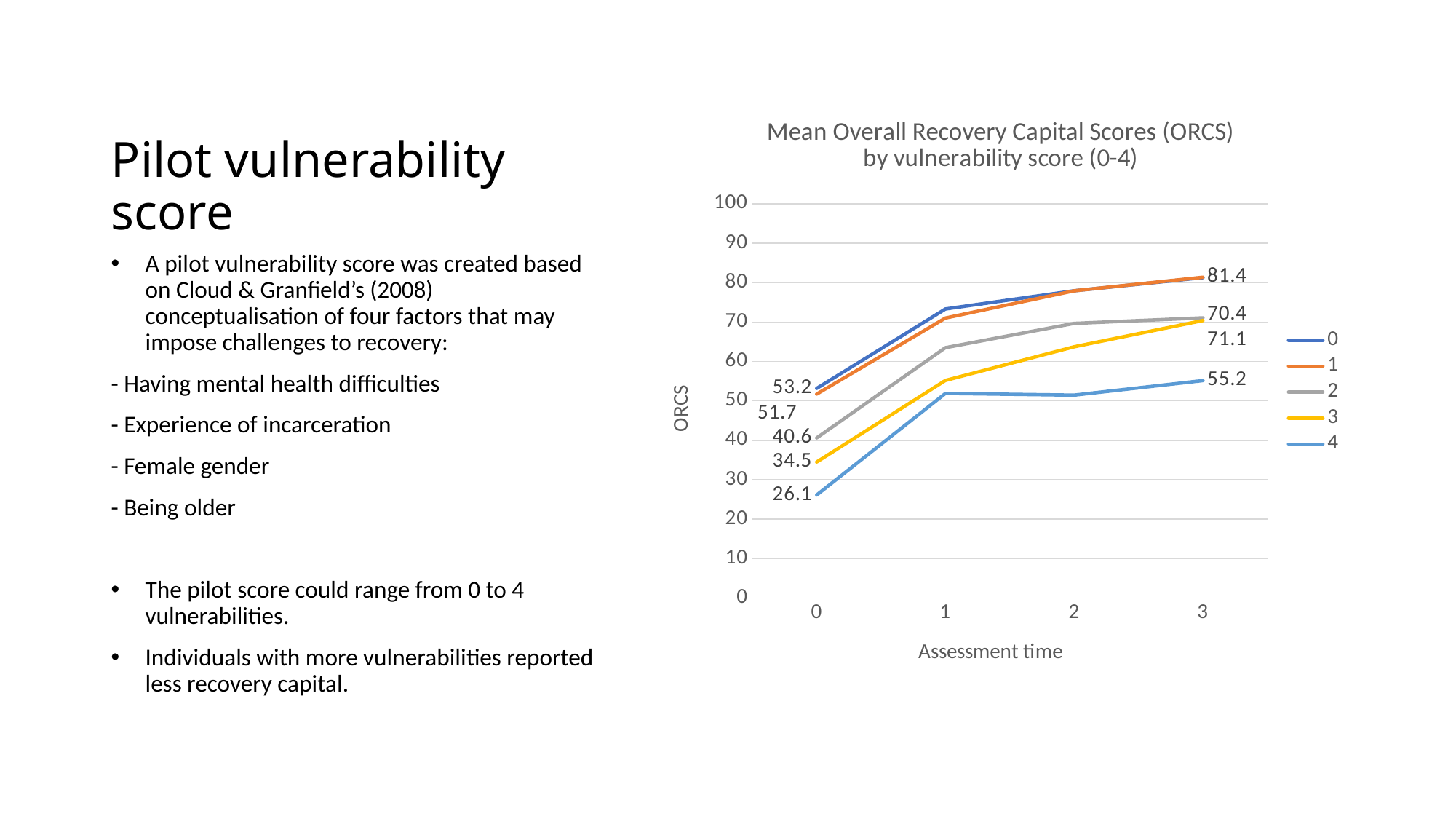
How many series does the legend list? 5 How many assessment time points are shown on the x axis? 4 What is the ORCS value for vulnerability score 0 at assessment time 0? 53.2 What kind of chart is shown on the slide? line chart By how much does the ORCS value for vulnerability score 4 increase from assessment time 0 to assessment time 3? 29.1 What is the ORCS value for vulnerability score 4 at assessment time 3? 55.2 What is the ORCS value for vulnerability score 3 at assessment time 0? 34.5 What is the ORCS value for vulnerability score 2 at assessment time 0? 40.6 Is the ORCS value for vulnerability score 2 at assessment time 2 greater or less than 60? greater Which vulnerability score series has the lowest ORCS value at assessment time 0? 4 What is the ORCS value for vulnerability score 4 at assessment time 0? 26.1 Does the ORCS value for vulnerability score 4 rise or fall from assessment time 0 to assessment time 3? rise